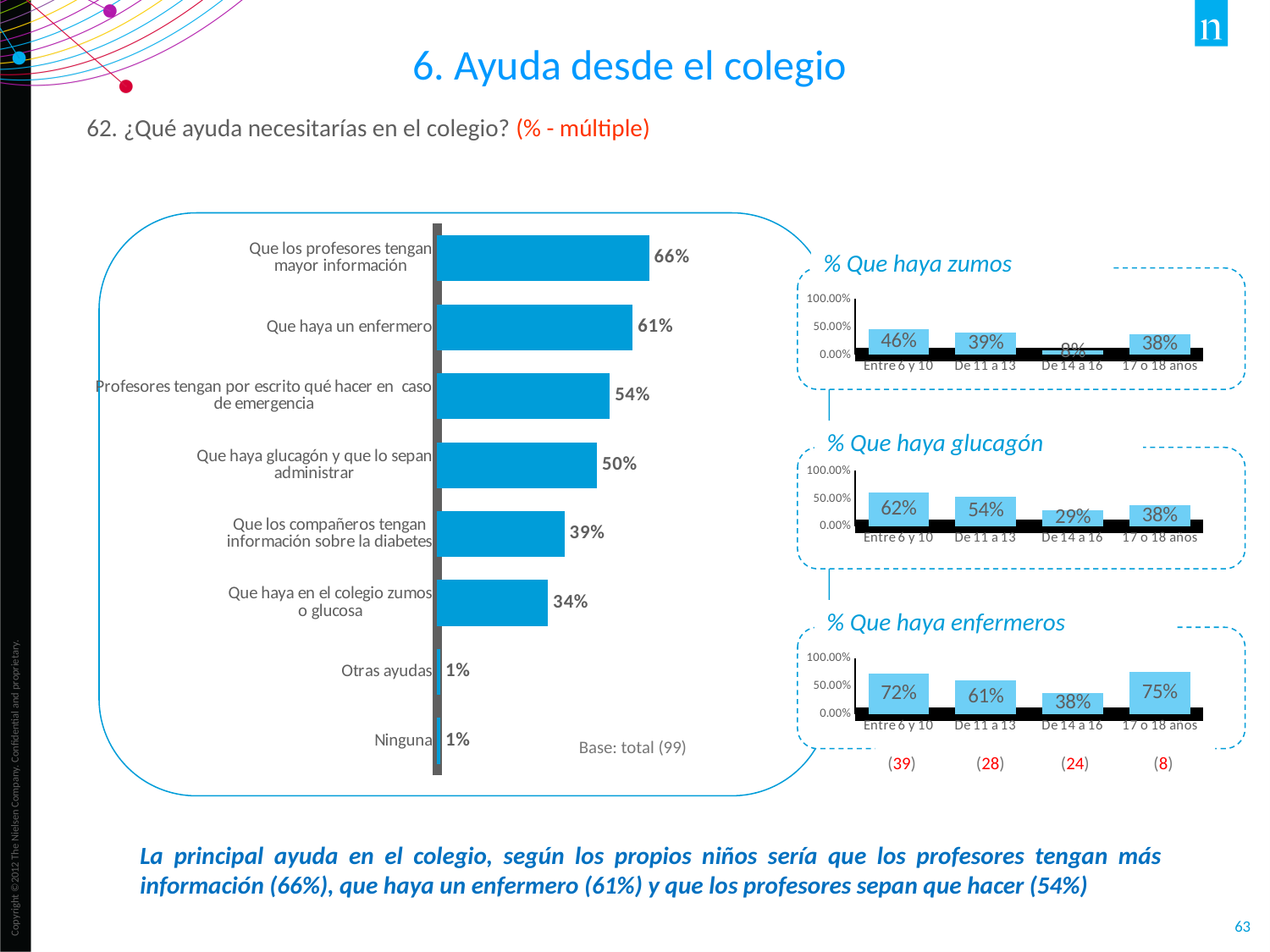
In the large bar chart on the left, what is the difference between 'Que los profesores tengan mayor información' and 'Que haya en el colegio zumos o glucosa'? 32% In the '% Que haya glucagón' chart, what is the value for 'Entre 6 y 10'? 62% In the large bar chart on the left, what percentage is shown for 'Que haya un enfermero'? 61% In the large bar chart on the left, how many categories are shown? 8 In the '% Que haya enfermeros' chart, what is the difference between 'Entre 6 y 10' and 'De 11 a 13'? 11% In the '% Que haya enfermeros' chart, which age group has the highest value? 17 o 18 años In the large bar chart on the left, what value is shown for 'Que haya glucagón y que lo sepan administrar'? 50% In the '% Que haya zumos' chart, which is larger: the value for 'Entre 6 y 10' or the value for 'De 11 a 13'? Entre 6 y 10 In the '% Que haya enfermeros' chart, what is the value for 'De 14 a 16'? 38% In the large bar chart on the left, which category has the highest value? Que los profesores tengan mayor información In the '% Que haya glucagón' chart, which age group has the lowest value? De 14 a 16 What type of chart is the large chart on the left? Bar chart